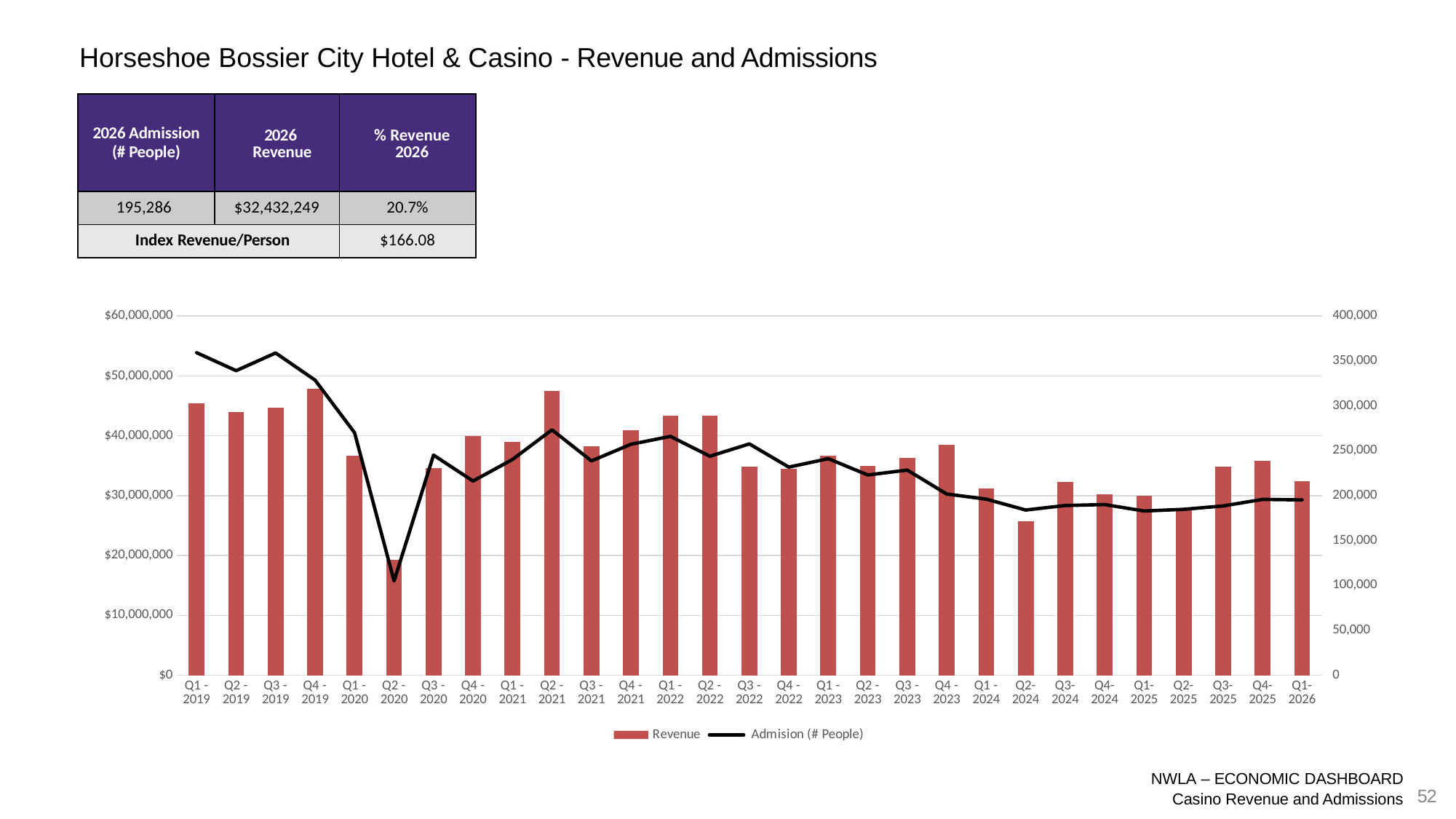
Which series is drawn as bars in the chart? Revenue Is the Revenue for Q4 - 2019 greater or less than $40,000,000? greater Which quarter has the larger Revenue bar, Q1 - 2019 or Q1 - 2020? Q1 - 2019 Is the Revenue for Q2 - 2020 greater or less than $20,000,000? less How many quarters are plotted along the x axis of the chart? 29 How many series does the chart legend list? 2 Is the Revenue for Q2-2024 greater or less than $30,000,000? less Which series is drawn as a line in the chart? Admision (# People) Which quarter has the lowest Revenue bar? Q2 - 2020 What kind of chart is shown on the slide? A combined bar and line chart In which quarter does the Admission line reach its lowest point? Q2 - 2020 Does the Admission line rise or fall from Q1 - 2019 to Q2 - 2020? fall